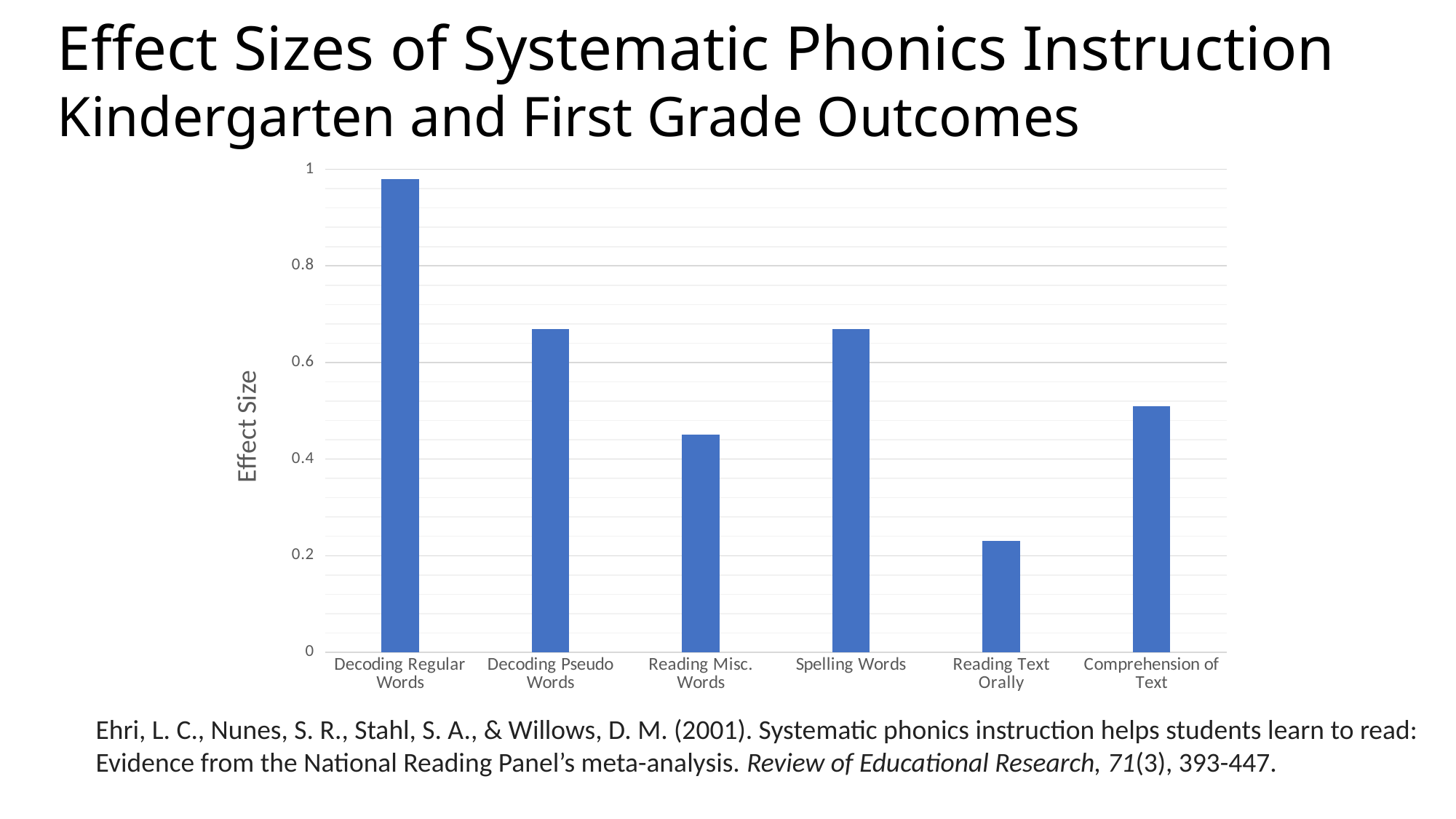
What kind of chart is shown on the slide? Bar chart Which outcome has the highest effect size? Decoding Regular Words Is the effect size for Decoding Pseudo Words greater or less than 0.6? greater Is the effect size for Reading Text Orally greater or less than 0.4? less Is the effect size for Decoding Regular Words greater or less than 0.8? greater Which has a larger effect size, Decoding Regular Words or Spelling Words? Decoding Regular Words Which has a larger effect size, Reading Text Orally or Reading Misc. Words? Reading Misc. Words How many outcome categories are plotted on the chart? 6 Which outcome has the lowest effect size? Reading Text Orally What is the label on the vertical axis of the chart? Effect Size